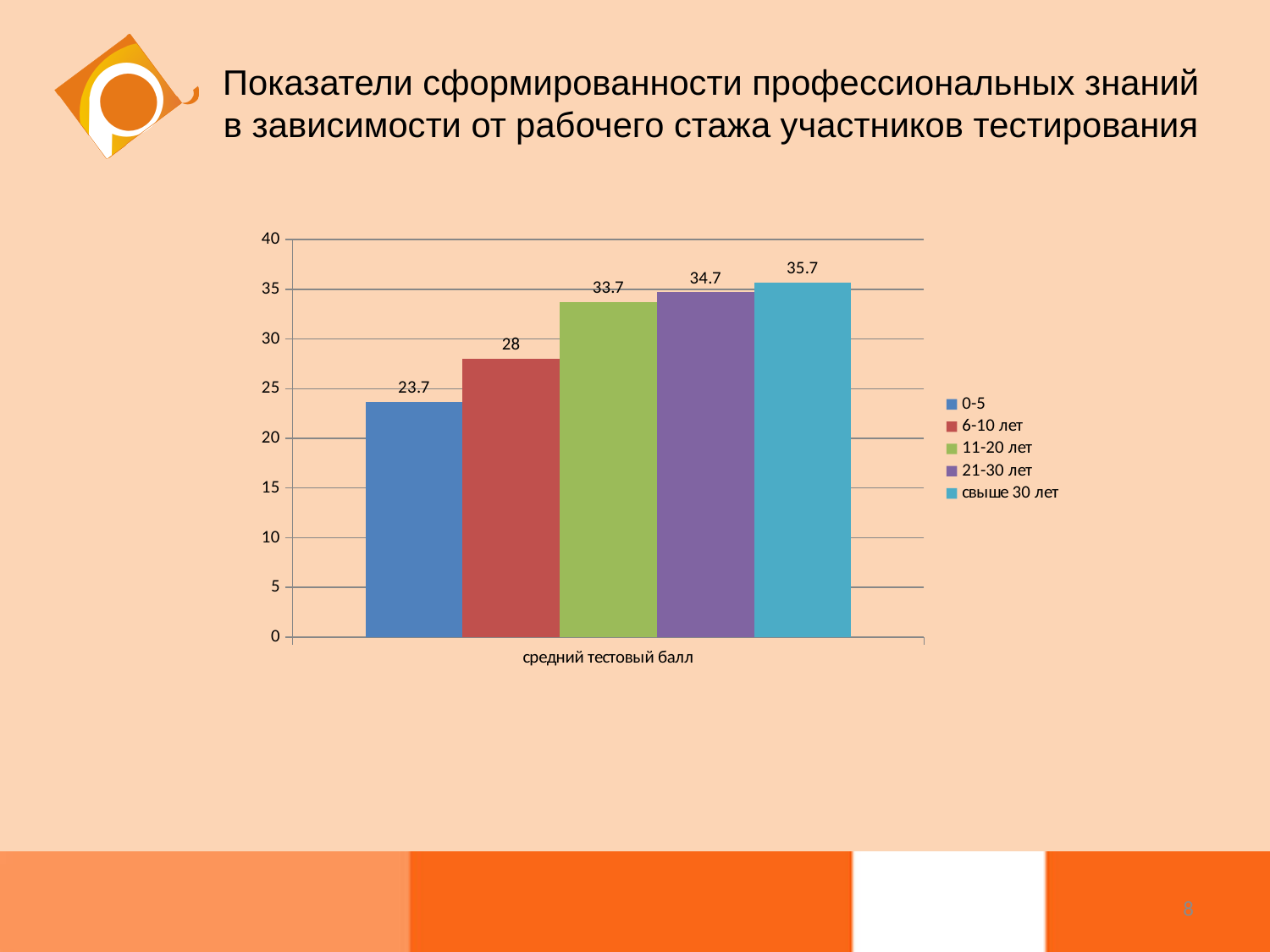
What is the average test score for the 6-10 лет group? 28 What is the value shown for the 21-30 лет group? 34.7 What is the average test score for participants with 0-5 years of experience? 23.7 Which is larger, the score for 6-10 лет or for 11-20 лет? 11-20 лет Do the scores rise or fall as work experience increases from left to right? rise Which experience group has the lowest average test score? 0-5 What is the difference between the scores of the свыше 30 лет group and the 0-5 group? 12 What kind of chart is shown on the slide? bar chart What is the difference between the 11-20 лет and 6-10 лет scores? 5.7 How many series does the legend list? 5 Which experience group has the highest average test score? свыше 30 лет Is the value for the 0-5 group greater or less than 25? less